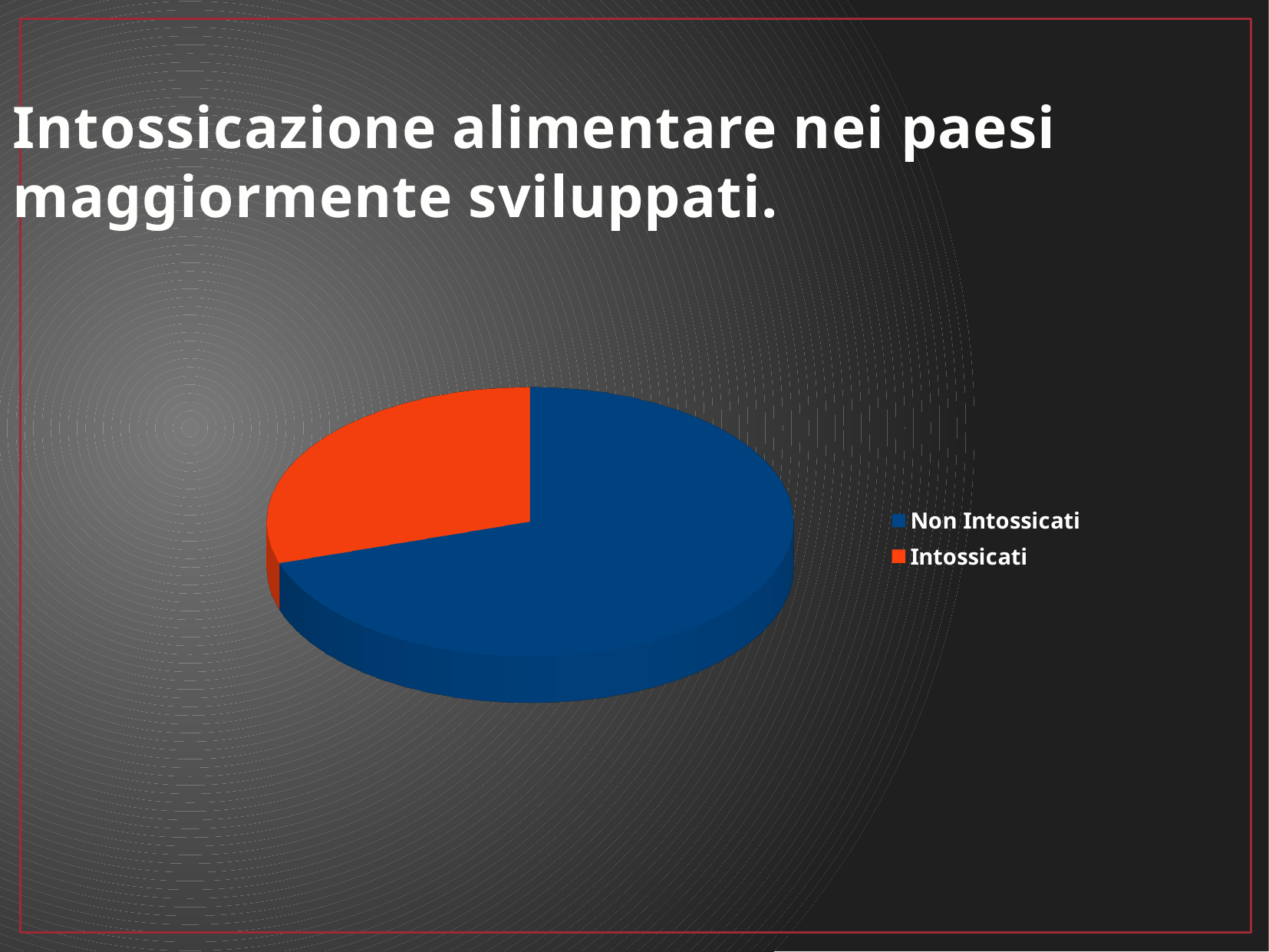
Which category has the largest slice of the pie chart? Non Intossicati What is the title of the slide containing the pie chart? Intossicazione alimentare nei paesi maggiormente sviluppati. How many slices does the pie chart have? 2 What colour is the Intossicati slice in the pie chart? Orange Which slice is larger, Non Intossicati or Intossicati? Non Intossicati How many entries does the legend of the pie chart list? 2 Which category has the smallest slice of the pie chart? Intossicati What kind of chart is shown on the slide? Pie chart Does the Non Intossicati slice take up more or less than half of the pie? More